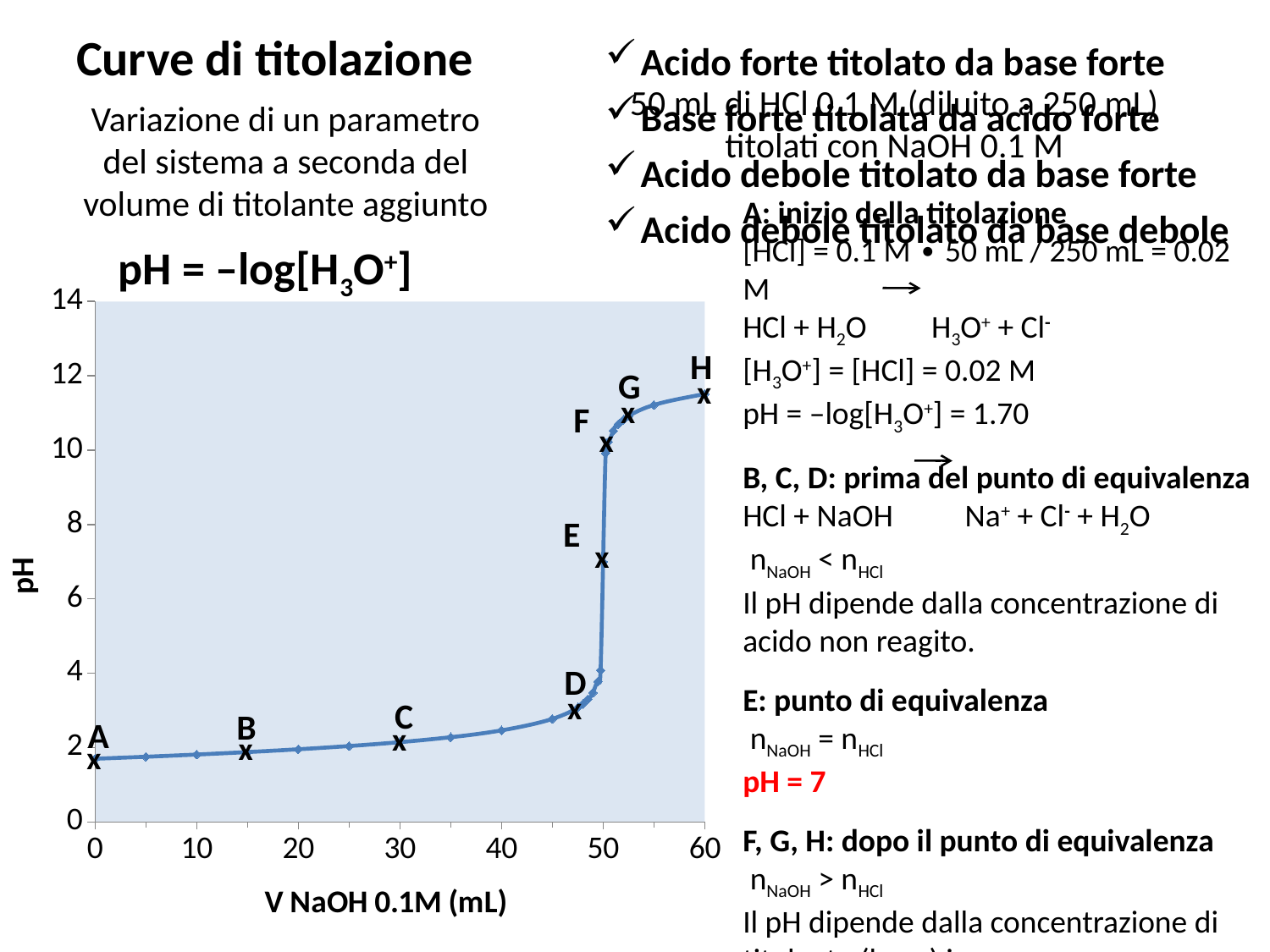
Is the pH at point F greater or less than 8? greater Is the pH at point C greater or less than 4? less How many labeled points (letters) are marked on the titration curve? 8 Which labeled point has the lowest pH on the curve? A What kind of chart is shown on the slide? line chart Is the pH at point H greater or less than 10? greater Which has the higher pH, point G or point D? G Which labeled point has the highest pH on the curve? H What is the label of the y axis of the chart? pH Does the pH rise or fall as the volume of NaOH increases along the x axis? rise What is the label of the x axis of the chart? V NaOH 0.1M (mL)